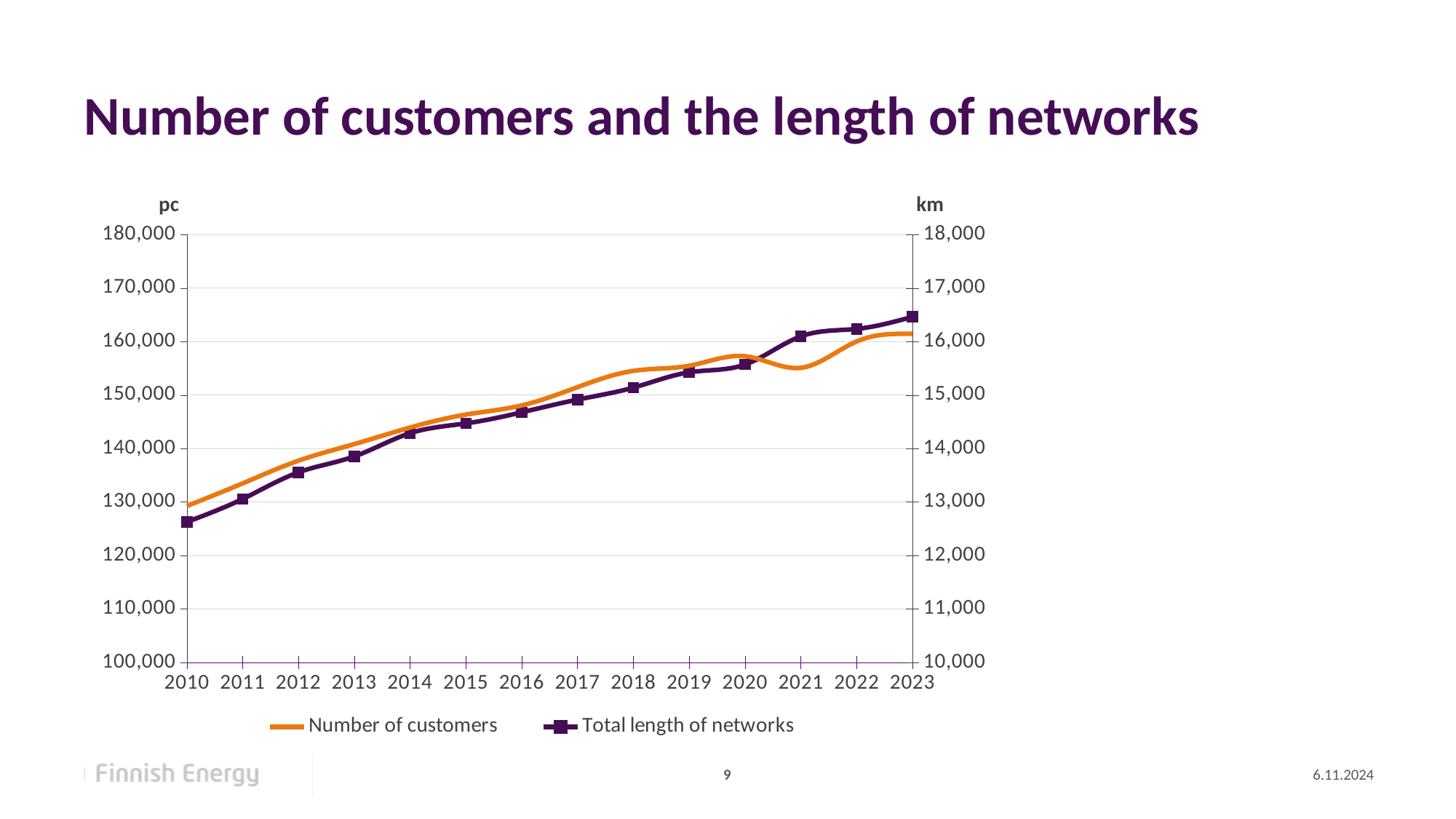
Is the Total length of networks in 2010 greater or less than 13,000? less What unit is shown on the right-hand axis? km How many series does the legend list? 2 Does the Number of customers rise or fall from 2010 to 2023? Rise Is the Number of customers in 2018 greater or less than 150,000? greater In which year is the Number of customers lowest? 2010 Is the Total length of networks in 2023 greater or less than 16,000? greater In which year is the Total length of networks highest? 2023 How many years are plotted along the x axis? 14 Does the Total length of networks rise or fall from 2010 to 2023? Rise What kind of chart is shown on the slide? Line chart